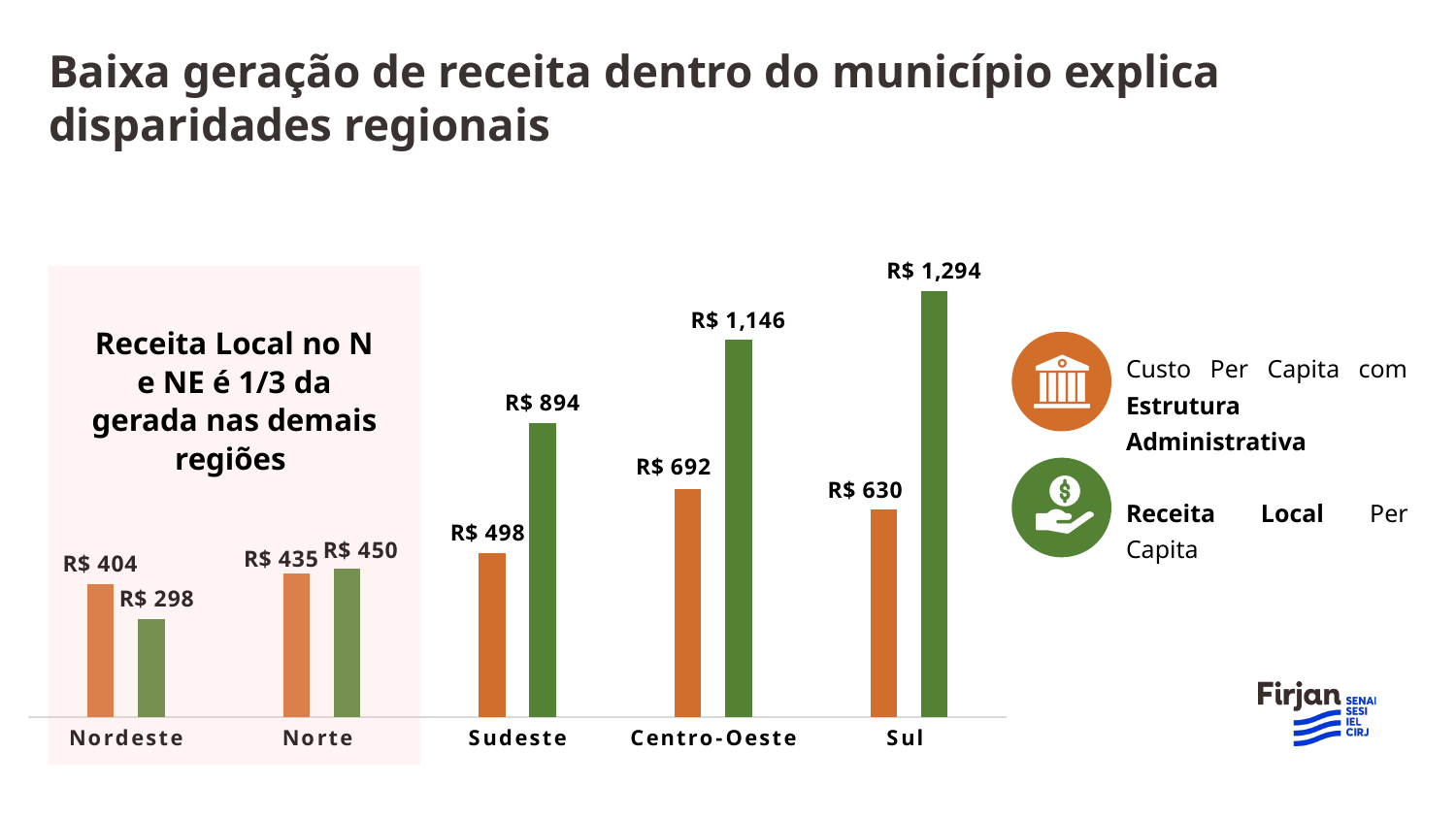
What is the Receita Local Per Capita for Sul? R$ 1,294 What type of chart is shown on the slide? Bar chart What is the Receita Local Per Capita for Sudeste? R$ 894 What is the Custo Per Capita com Estrutura Administrativa for Centro-Oeste? R$ 692 Which region has the highest Custo Per Capita com Estrutura Administrativa? Centro-Oeste For Nordeste, which is larger: Custo Per Capita com Estrutura Administrativa or Receita Local Per Capita? Custo Per Capita com Estrutura Administrativa Which region has the lowest Receita Local Per Capita? Nordeste How many regions are shown on the x axis of the chart? 5 What is the difference between Receita Local Per Capita and Custo Per Capita com Estrutura Administrativa for Sul? R$ 664 What is the Custo Per Capita com Estrutura Administrativa for Nordeste? R$ 404 Which region has the highest Receita Local Per Capita? Sul How many series does the chart's legend list? 2